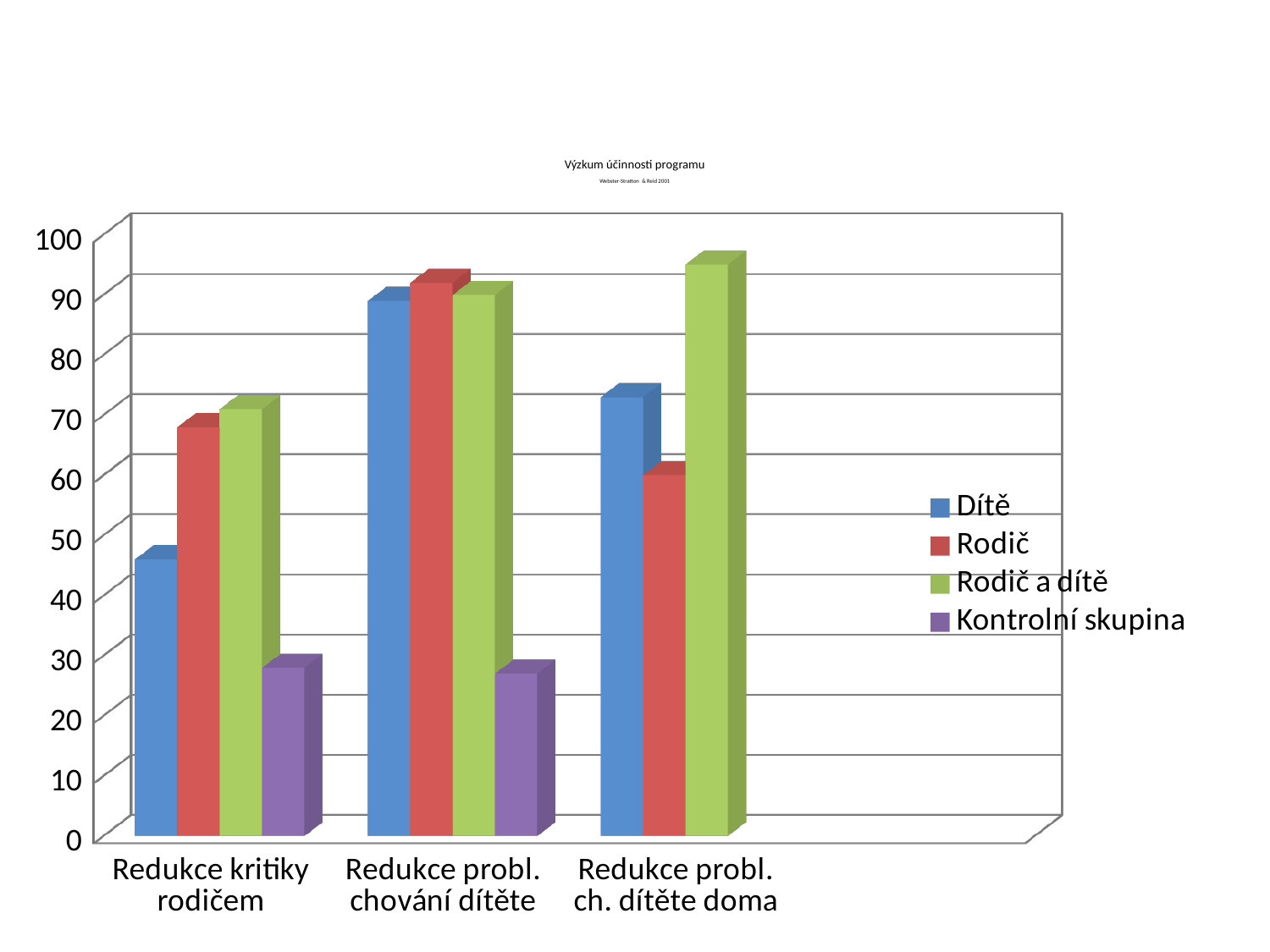
Is the value for Dítě in 'Redukce kritiky rodičem' greater or less than 50? less What is the title of the chart? Výzkum účinnosti programu In the category 'Redukce probl. ch. dítěte doma', which is larger: Dítě or Rodič? Dítě What kind of chart is shown on the slide? bar chart How many categories are shown on the x axis? 3 Which series has the lowest value in the category 'Redukce probl. chování dítěte'? Kontrolní skupina Is the value for Kontrolní skupina in 'Redukce kritiky rodičem' greater or less than 40? less Is the value for Rodič a dítě in 'Redukce probl. ch. dítěte doma' greater or less than 90? greater Which series has the lowest value in the category 'Redukce kritiky rodičem'? Kontrolní skupina How many series does the legend list? 4 Which series has the highest value in the category 'Redukce probl. ch. dítěte doma'? Rodič a dítě